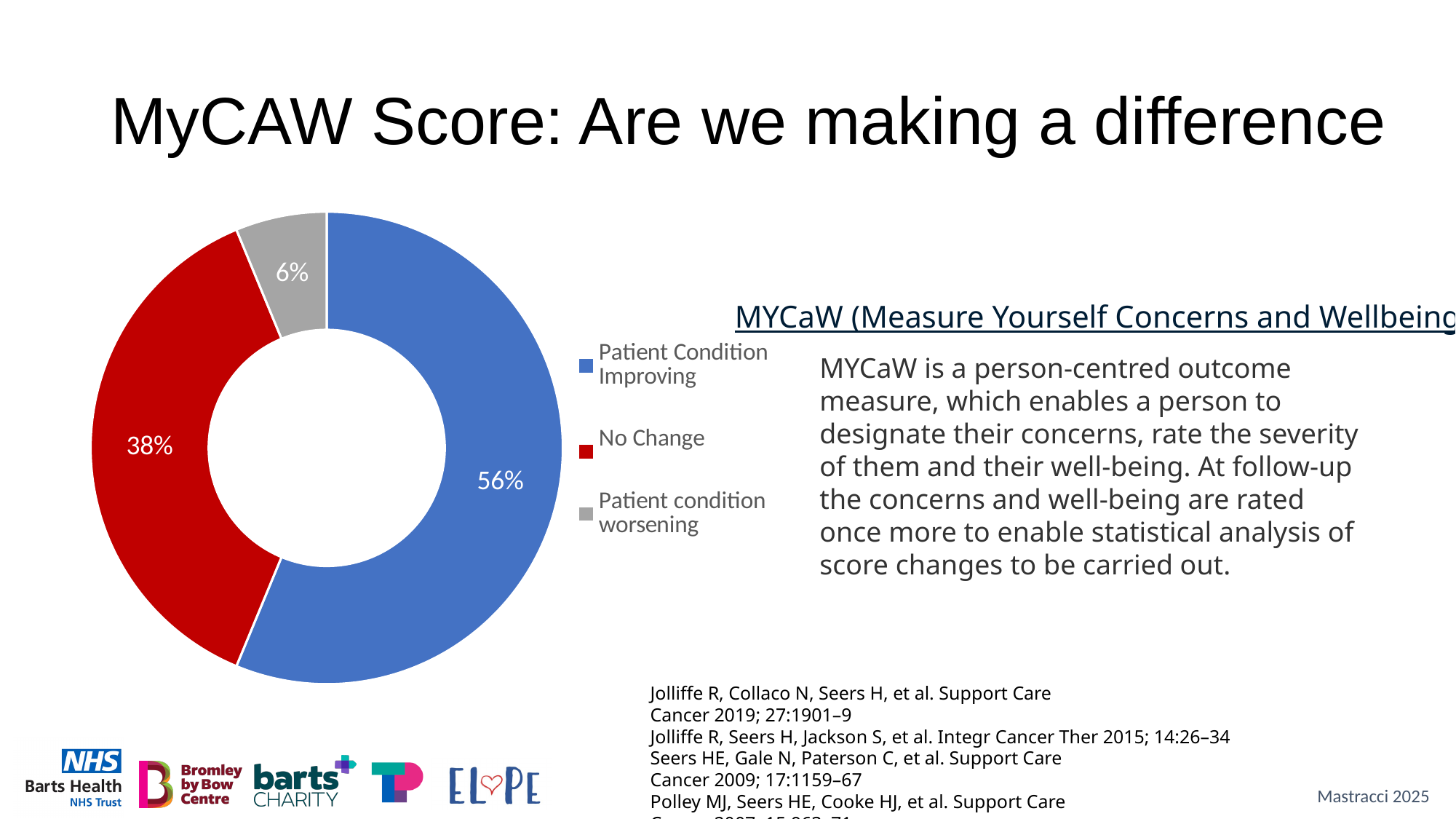
What kind of chart is shown on the slide? Doughnut chart What percentage of patients had their condition improving? 56% What percentage of patients showed no change? 38% How many categories does the chart show? 3 What colour represents the No Change category? Red Which is larger, the share for No Change or the share for Patient condition worsening? No Change Which category has the smallest share of the chart? Patient condition worsening What is the difference in percentage points between Patient Condition Improving and No Change? 18 What colour represents the Patient condition worsening category? Grey What percentage of patients had their condition worsening? 6% What is the difference in percentage points between No Change and Patient condition worsening? 32 Which category has the largest share of the chart? Patient Condition Improving